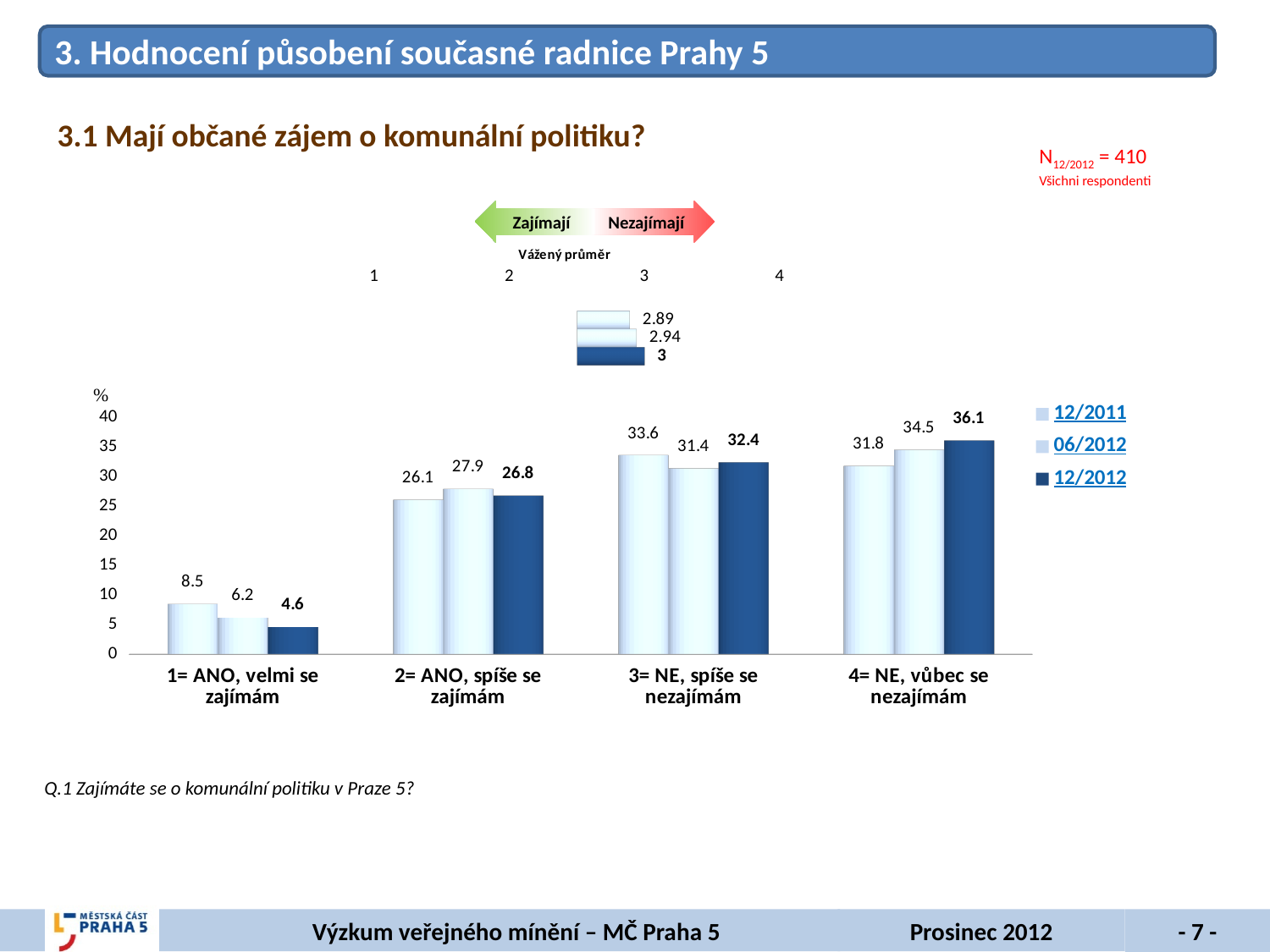
In the main bar chart, which category has the highest value in the 12/2012 series? 4= NE, vůbec se nezajímám In the main bar chart, which category has the lowest value in the 12/2011 series? 1= ANO, velmi se zajímám In the main bar chart, which is larger for '2= ANO, spíše se zajímám': the 06/2012 value or the 12/2012 value? 06/2012 In the 'Vážený průměr' chart at the top, what is the value of the darkest (bottom) bar? 3 In the 'Vážený průměr' chart at the top, what is the value of the topmost bar? 2.89 What kind of chart is the main chart on the slide? bar chart In the main bar chart, what is the value for '4= NE, vůbec se nezajímám' in the 06/2012 series? 34.5 In the main bar chart, what is the value for '3= NE, spíše se nezajímám' in the 12/2011 series? 33.6 How many series does the legend of the main bar chart list? 3 How many categories are shown on the x axis of the main bar chart? 4 In the main bar chart, what is the difference between the 12/2012 and 12/2011 values for '4= NE, vůbec se nezajímám'? 4.3 In the main bar chart, what is the value for '1= ANO, velmi se zajímám' in the 12/2012 series? 4.6